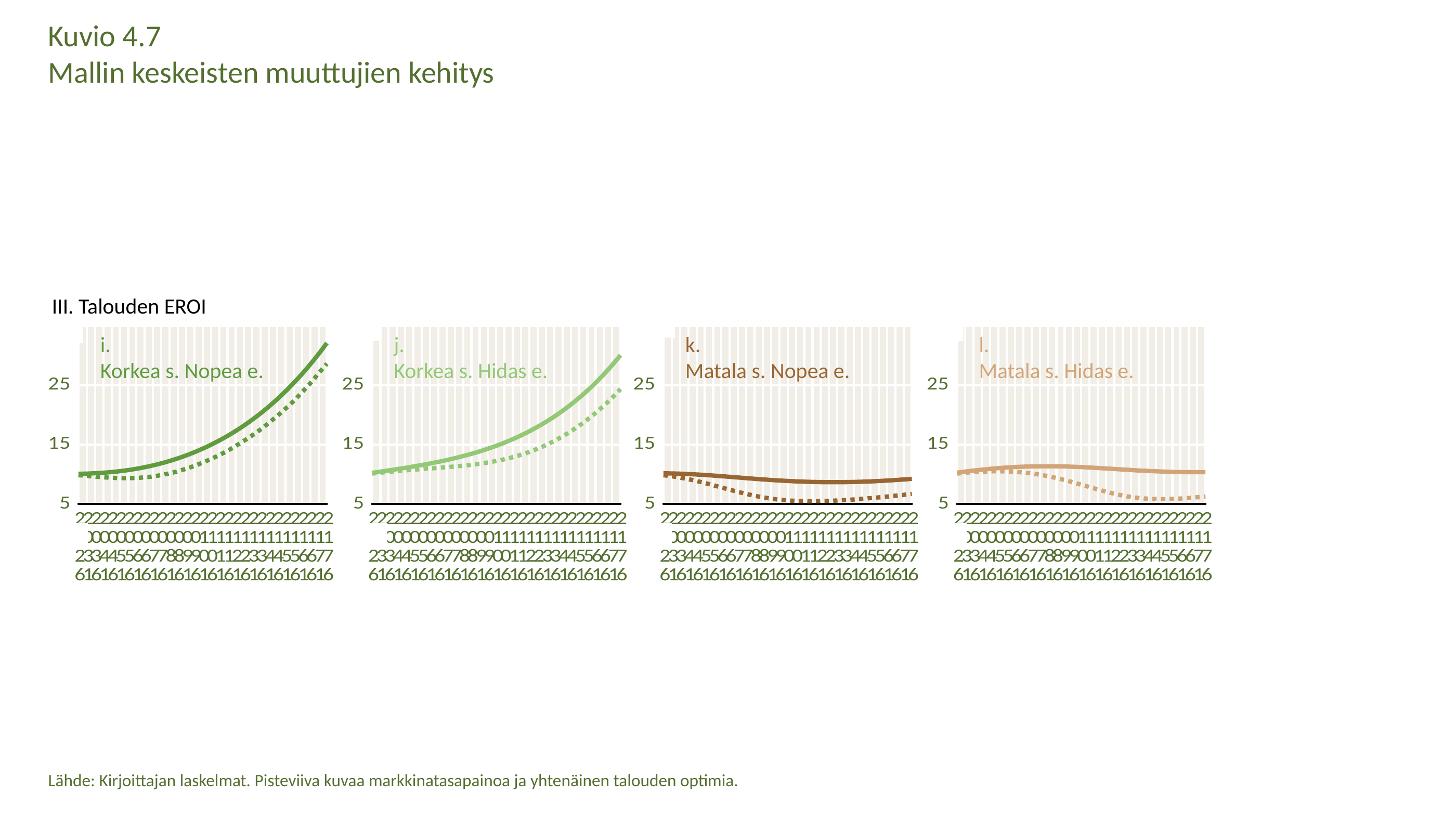
According to the footnote, which line style represents the market equilibrium (markkinatasapaino)? dotted line In chart i. Korkea s. Nopea e., is the starting value of the solid line greater or less than 15? less How many lines are plotted in chart k. Matala s. Nopea e.? 2 How many charts are shown under the heading III. Talouden EROI? 4 What is the title of the chart panel labelled k.? Matala s. Nopea e. In chart j. Korkea s. Hidas e., is the final value of the solid line greater or less than 25? greater In chart i. Korkea s. Nopea e., does the solid line rise or fall from left to right? rise In chart l. Matala s. Hidas e., is the highest point of the solid line greater or less than 15? less What kind of chart is chart i. Korkea s. Nopea e.? line chart In chart j. Korkea s. Hidas e., does the dotted line rise or fall from left to right? rise